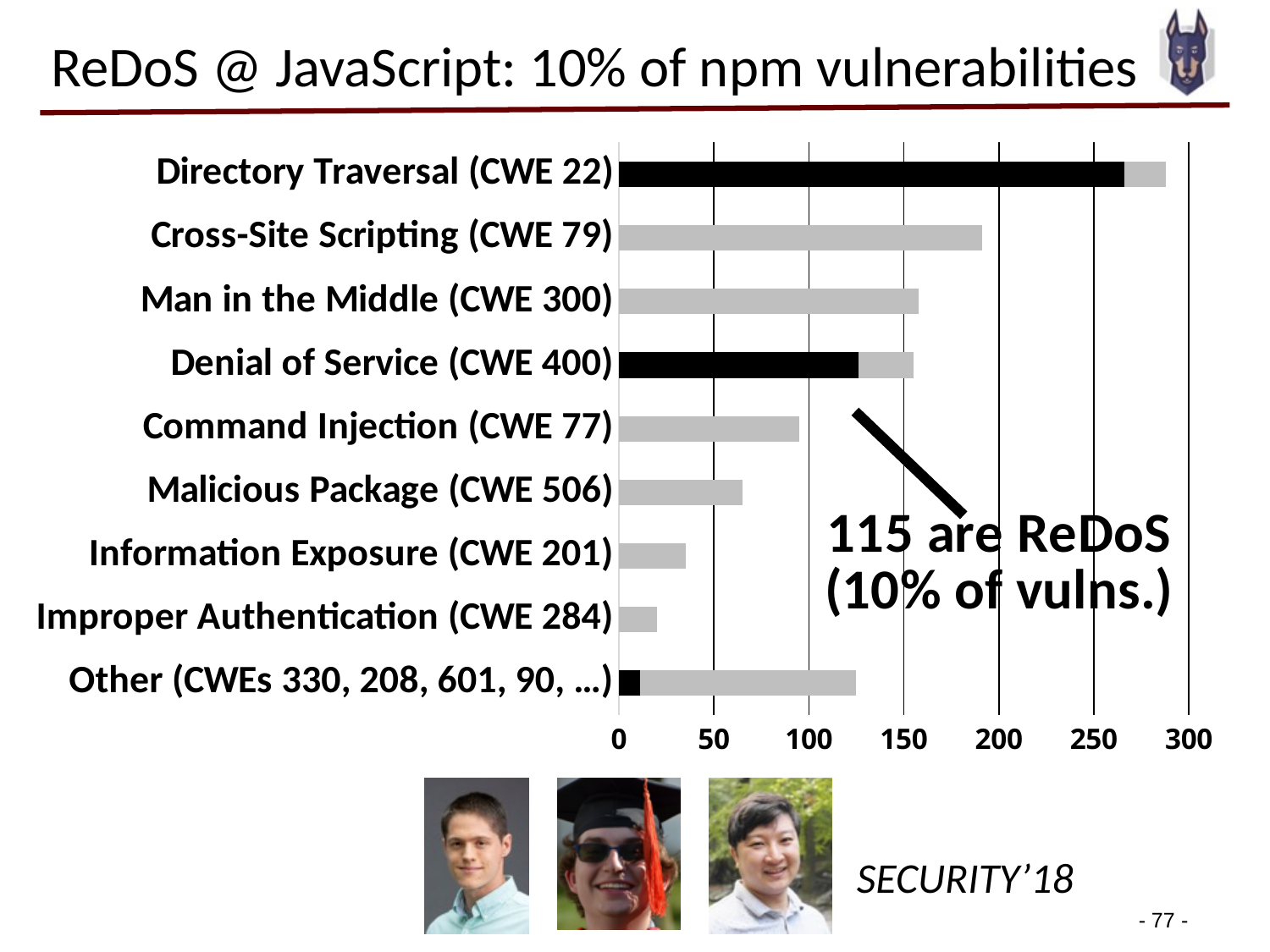
Is the value for Other (CWEs 330, 208, 601, 90, ...) greater or less than 100? greater Which has the larger value: Cross-Site Scripting (CWE 79) or Man in the Middle (CWE 300)? Cross-Site Scripting (CWE 79) Is the value for Cross-Site Scripting (CWE 79) greater or less than 150? greater Which category has the longest bar on the chart? Directory Traversal (CWE 22) How many vulnerability categories are plotted on the chart? 9 Which category has the shortest bar on the chart? Improper Authentication (CWE 284) Is the value for Information Exposure (CWE 201) greater or less than 50? less What is the title of the slide? ReDoS @ JavaScript: 10% of npm vulnerabilities Which has the larger value: Command Injection (CWE 77) or Malicious Package (CWE 506)? Command Injection (CWE 77) What kind of chart is shown on the slide? bar chart According to the annotation on the chart, how many of the vulnerabilities are ReDoS? 115